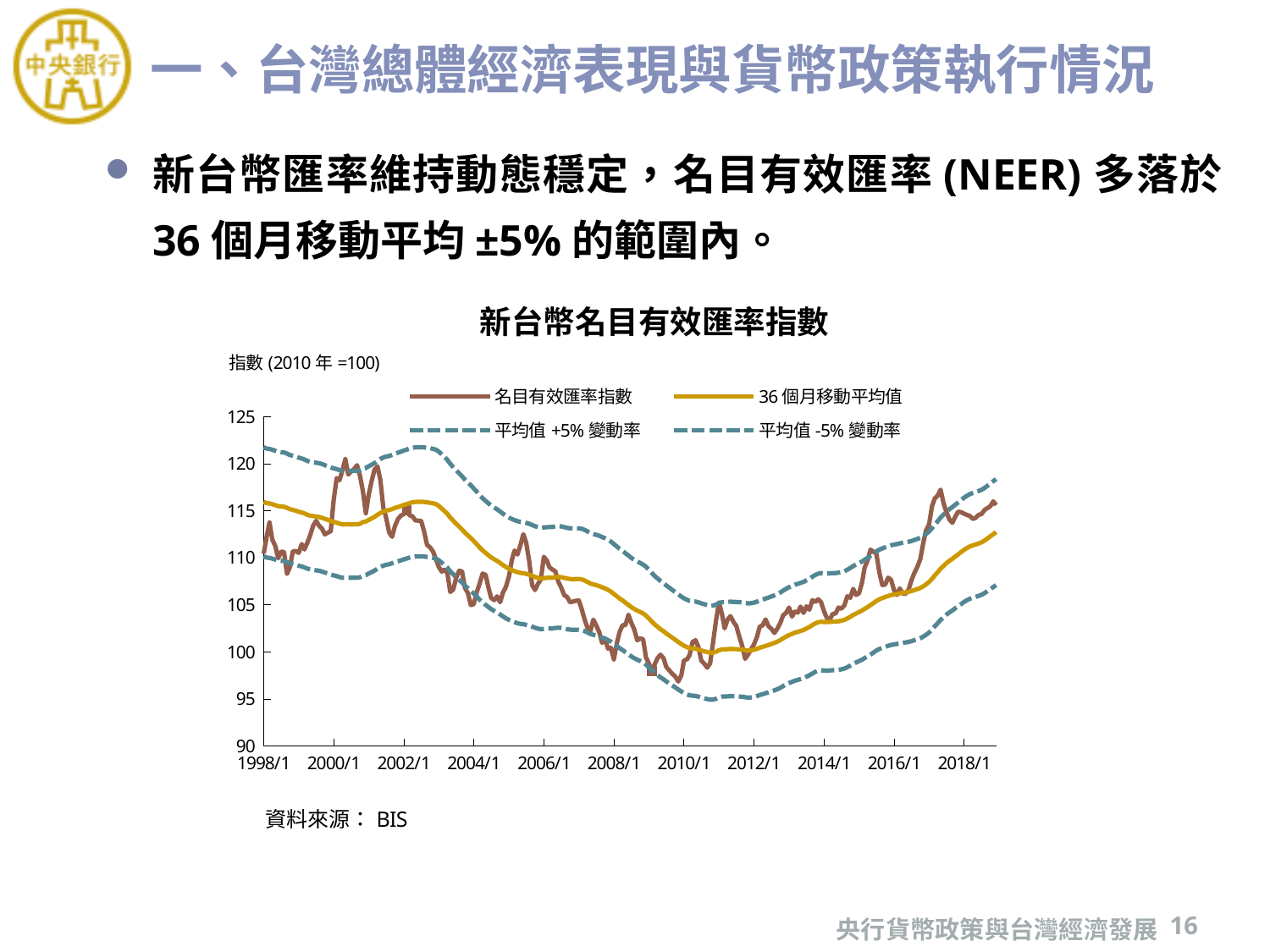
What is the data source given below the chart? BIS What is the title of the chart? 新台幣名目有效匯率指數 What kind of chart is shown on the slide? line chart Does the 36 個月移動平均值 line rise or fall between 2012/1 and 2018/1? rise Is the value of 36 個月移動平均值 at 1998/1 greater or less than 110? greater Is the value of 平均值 -5% 變動率 at 2012/1 greater or less than 100? less How many series does the legend of the chart list? 4 At 2010/1, which is larger: 名目有效匯率指數 or 36 個月移動平均值? 36 個月移動平均值 Is the value of 名目有效匯率指數 at 2018/1 greater or less than 110? greater Does the 36 個月移動平均值 line rise or fall between 2002/1 and 2010/1? fall How many year labels are shown on the x axis of the chart? 11